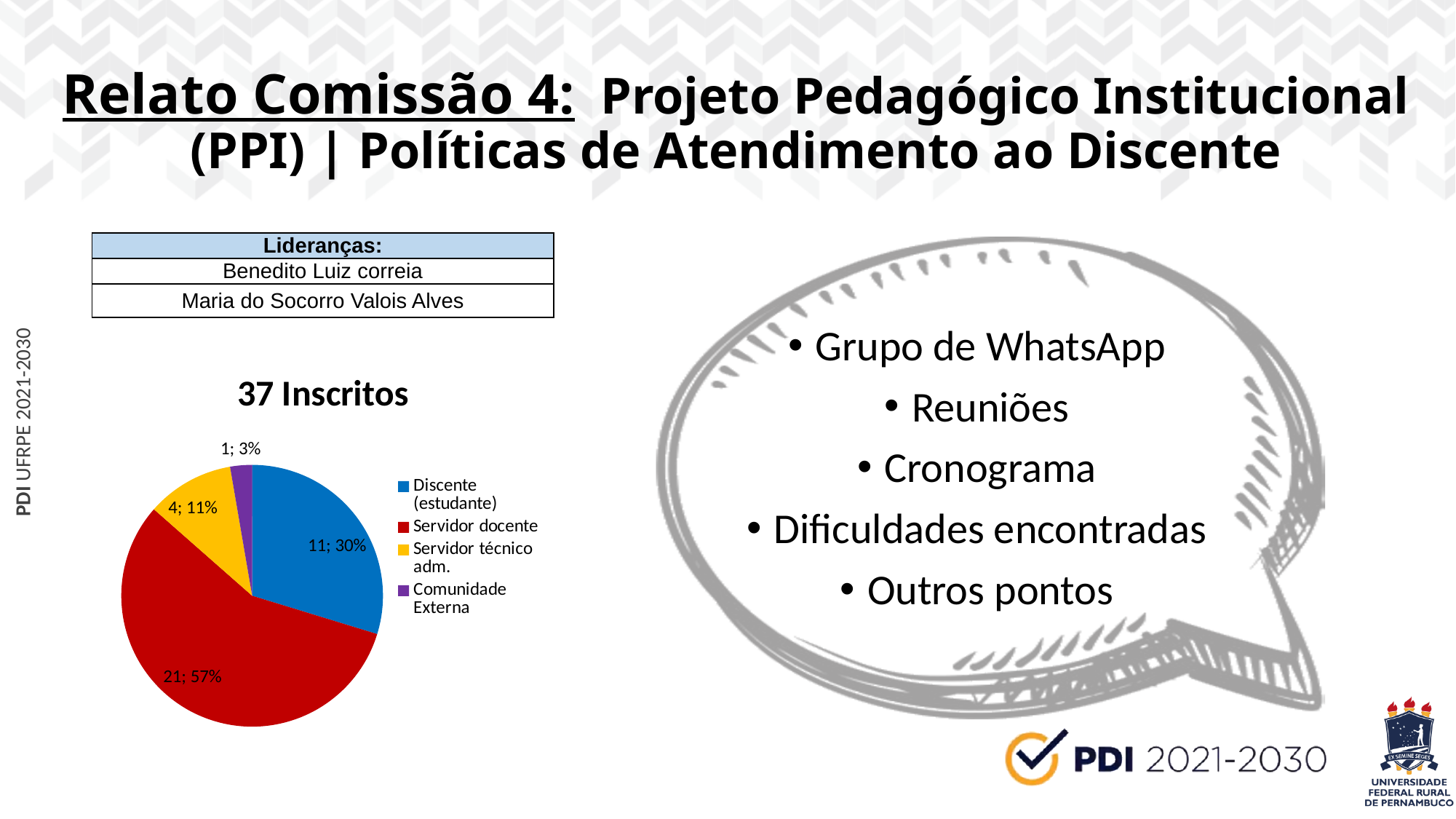
Which is larger, the count for Servidor técnico adm. or the count for Comunidade Externa? Servidor técnico adm. Which category has the largest slice of the pie chart? Servidor docente What is the difference in count between Servidor docente and Discente (estudante)? 10 How many entries does the legend of the pie chart list? 4 What percentage share does Discente (estudante) have in the pie chart? 30% What kind of chart is shown on the slide? Pie chart Which category has the smallest slice of the pie chart? Comunidade Externa What is the title of the pie chart? 37 Inscritos How many inscritos are in the Servidor docente category? 21 How many categories does the pie chart have? 4 What percentage share does Comunidade Externa have in the pie chart? 3% How many inscritos are in the Servidor técnico adm. category? 4